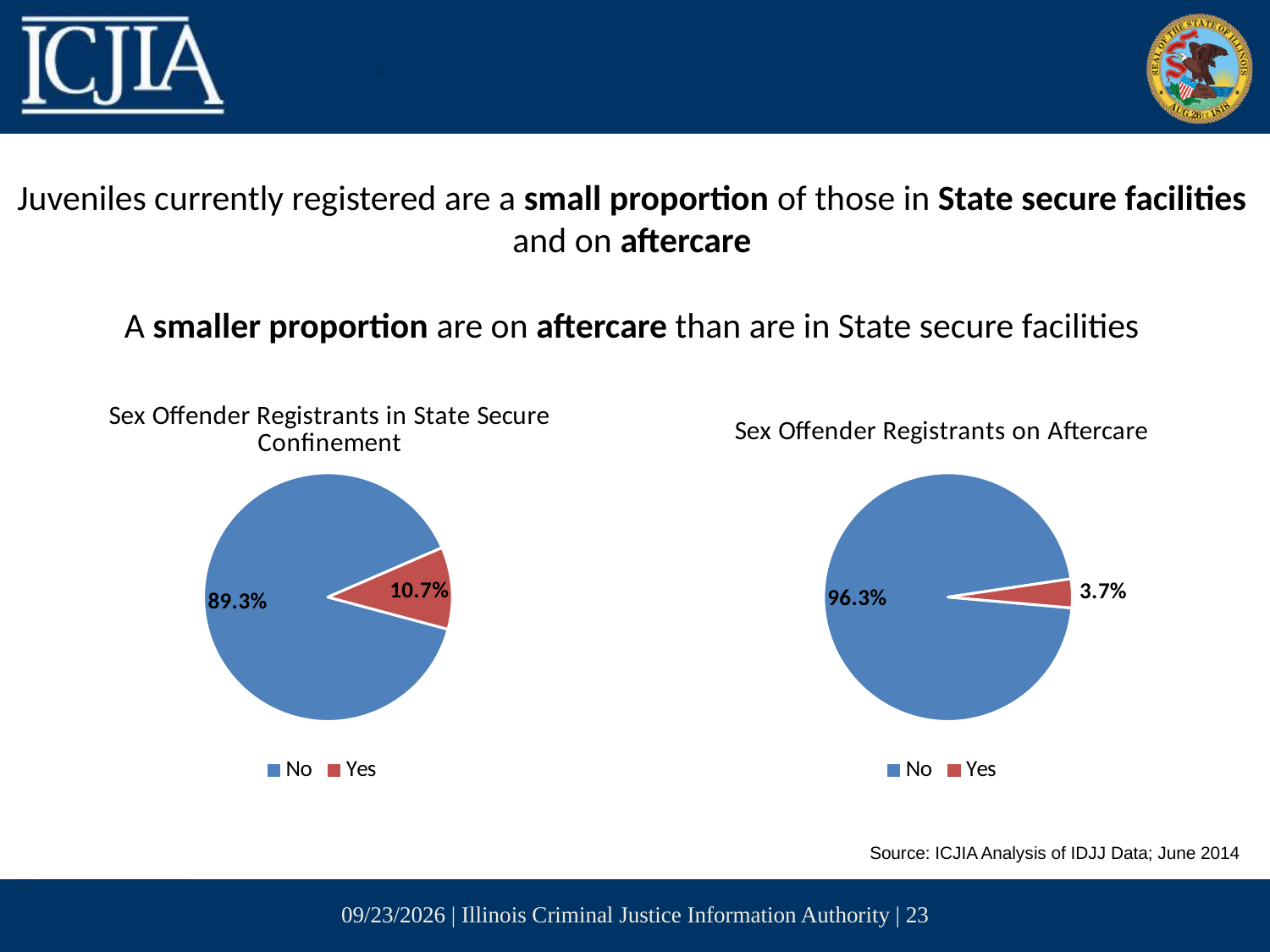
In the 'Sex Offender Registrants in State Secure Confinement' chart, which slice is the largest? No Which chart has the larger 'Yes' share: 'Sex Offender Registrants in State Secure Confinement' or 'Sex Offender Registrants on Aftercare'? Sex Offender Registrants in State Secure Confinement In the 'Sex Offender Registrants on Aftercare' chart, what percentage is shown for 'Yes'? 3.7% What type of chart is 'Sex Offender Registrants on Aftercare'? Pie chart In the 'Sex Offender Registrants in State Secure Confinement' chart, what percentage is shown for 'Yes'? 10.7% In the 'Sex Offender Registrants on Aftercare' chart, what percentage is shown for 'No'? 96.3% In the 'Sex Offender Registrants in State Secure Confinement' chart, what is the difference between the 'No' and 'Yes' percentages? 78.6% How many entries does the legend of the 'Sex Offender Registrants in State Secure Confinement' chart list? 2 How many slices does the 'Sex Offender Registrants on Aftercare' pie chart have? 2 In the 'Sex Offender Registrants in State Secure Confinement' chart, what percentage is shown for 'No'? 89.3% In the 'Sex Offender Registrants on Aftercare' chart, what colour is the 'Yes' slice? Red In the 'Sex Offender Registrants on Aftercare' chart, which slice is the smallest? Yes